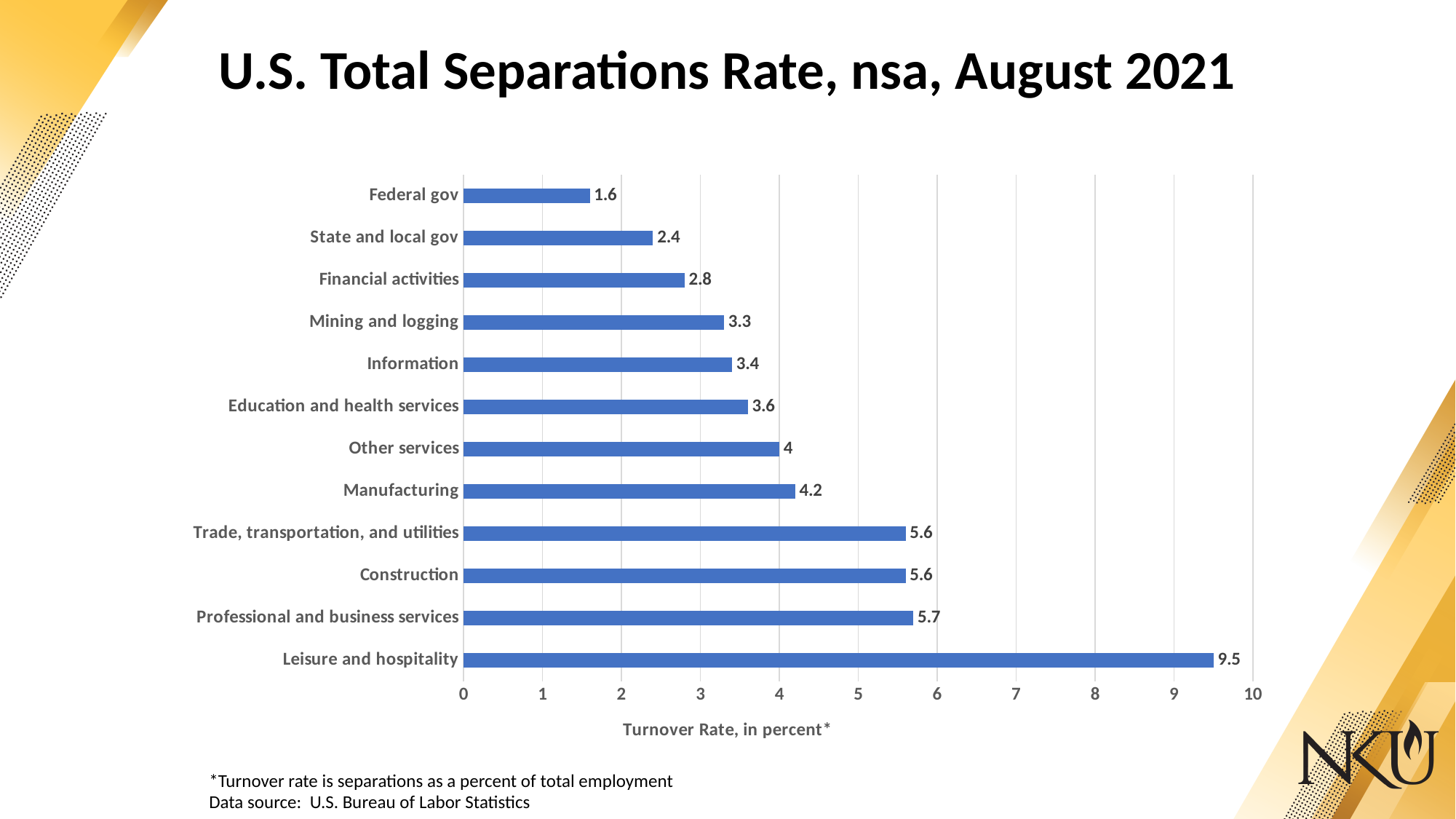
What is the turnover rate for Leisure and hospitality? 9.5 Which category has the highest turnover rate? Leisure and hospitality Is the value for Trade, transportation, and utilities greater or less than 5? greater What kind of chart is shown on the slide? Bar chart What is the difference between the turnover rates for Leisure and hospitality and Professional and business services? 3.8 Which category has the lowest turnover rate? Federal gov Which has a higher turnover rate, Information or Other services? Other services What is the turnover rate for Manufacturing? 4.2 What is the turnover rate for Federal gov? 1.6 What is the label of the horizontal axis? Turnover Rate, in percent* How many categories are shown in the chart? 12 What is the title of the chart? U.S. Total Separations Rate, nsa, August 2021